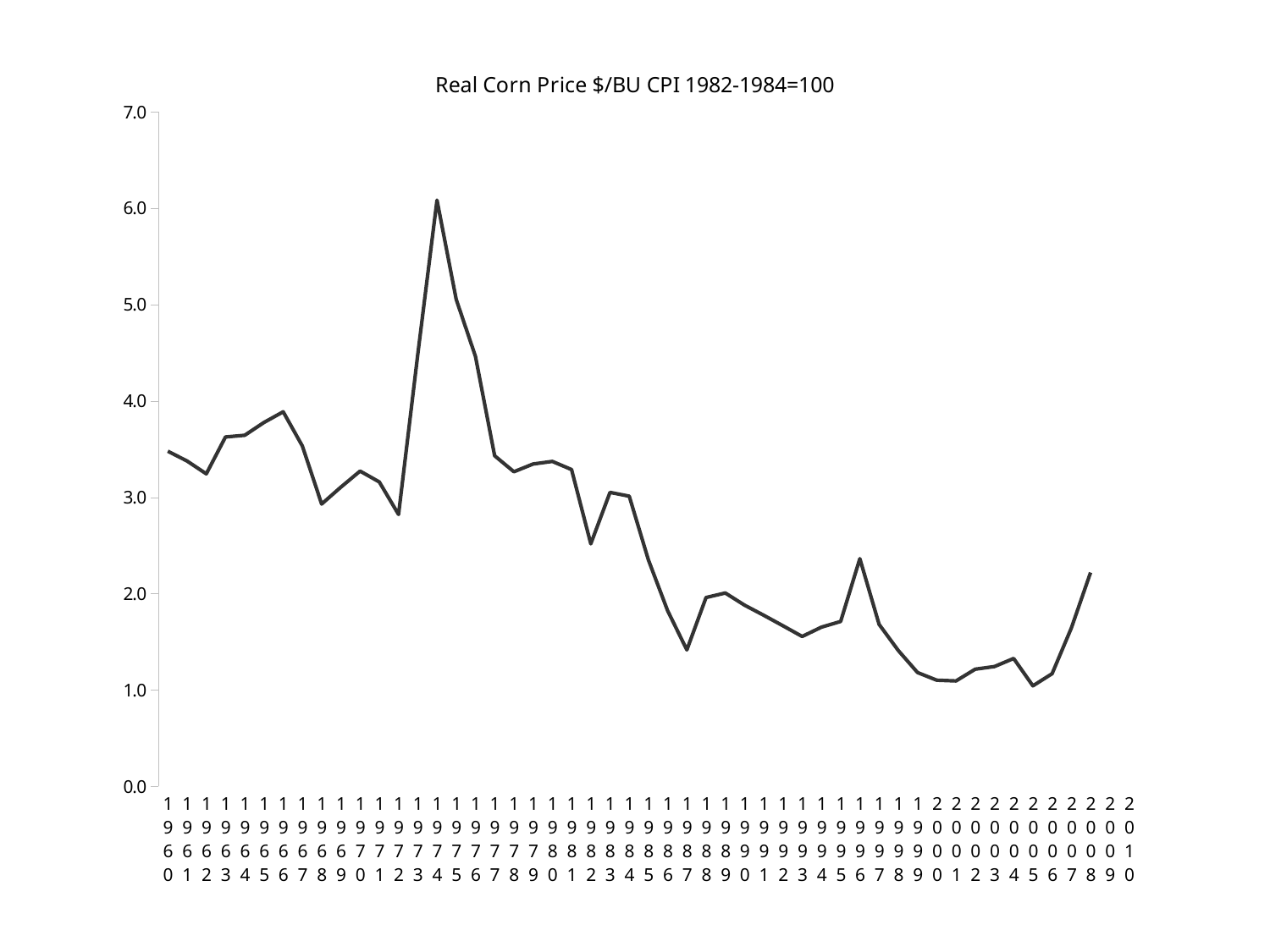
What is the first year shown on the x axis? 1960 What is the title of the chart? Real Corn Price $/BU CPI 1982-1984=100 Which year has the higher real corn price, 1981 or 1987? 1981 Which year has the higher real corn price, 1974 or 1996? 1974 Overall, does the real corn price rise or fall from 1974 to 1987? fall Is the value for 2005 greater or less than 2.0? less In which year does the real corn price reach its highest value? 1974 Is the value for 1987 greater or less than 2.0? less Is the value for 1960 greater or less than 3.0? greater What kind of chart is shown on the slide? line chart